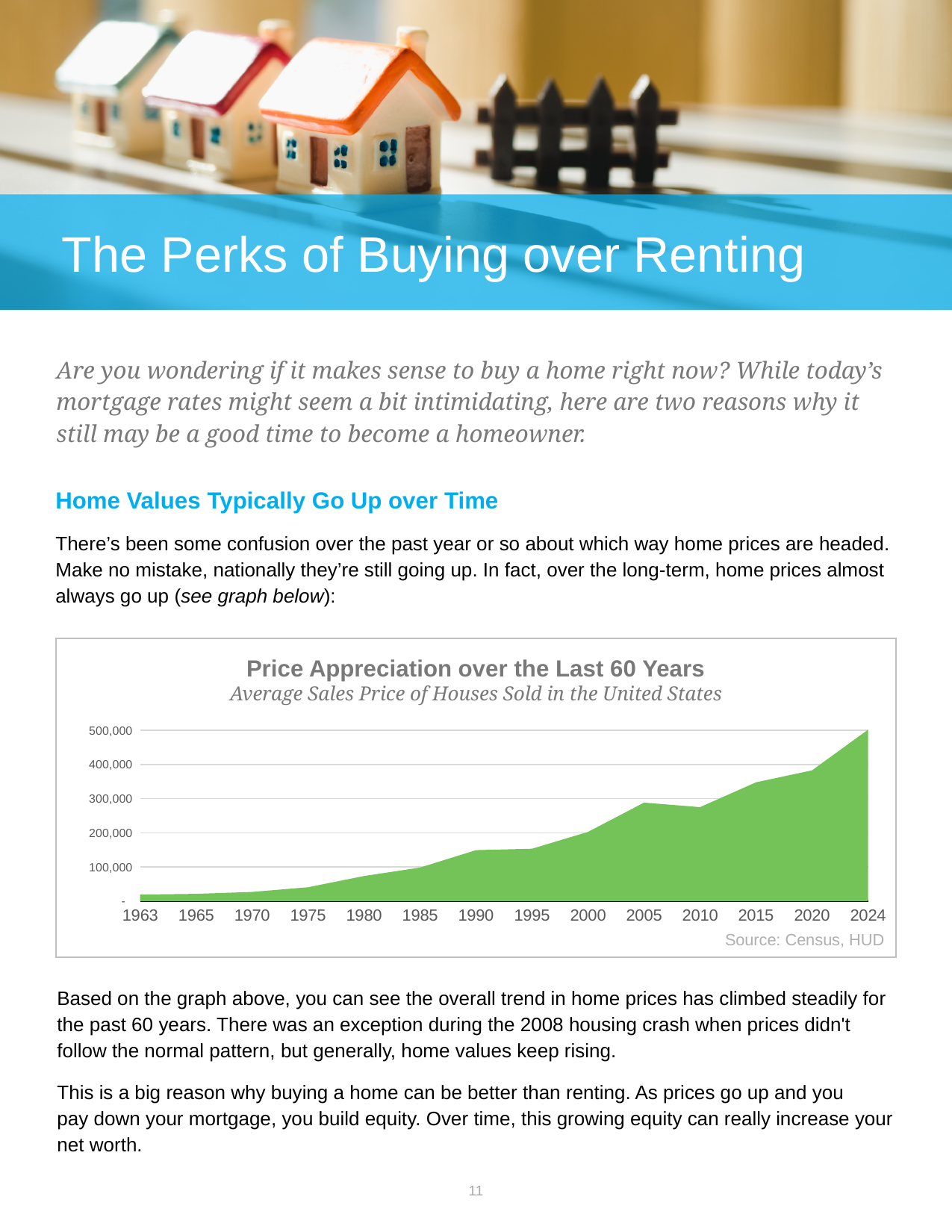
Is the value for 1980 greater or less than 100,000? less Is the value for 2010 greater or less than 300,000? less Which year on the x axis has the lowest average sales price? 1963 What source is cited for the chart data? Census, HUD What kind of chart is shown on the slide? Area chart How many year labels are shown on the x axis of the chart? 14 Is the value for 1990 greater or less than 100,000? greater Which year has the larger average sales price, 2010 or 2015? 2015 What is the title of the chart? Price Appreciation over the Last 60 Years Do home prices generally rise or fall across the years shown on the x axis? Rise Which year on the x axis has the highest average sales price? 2024